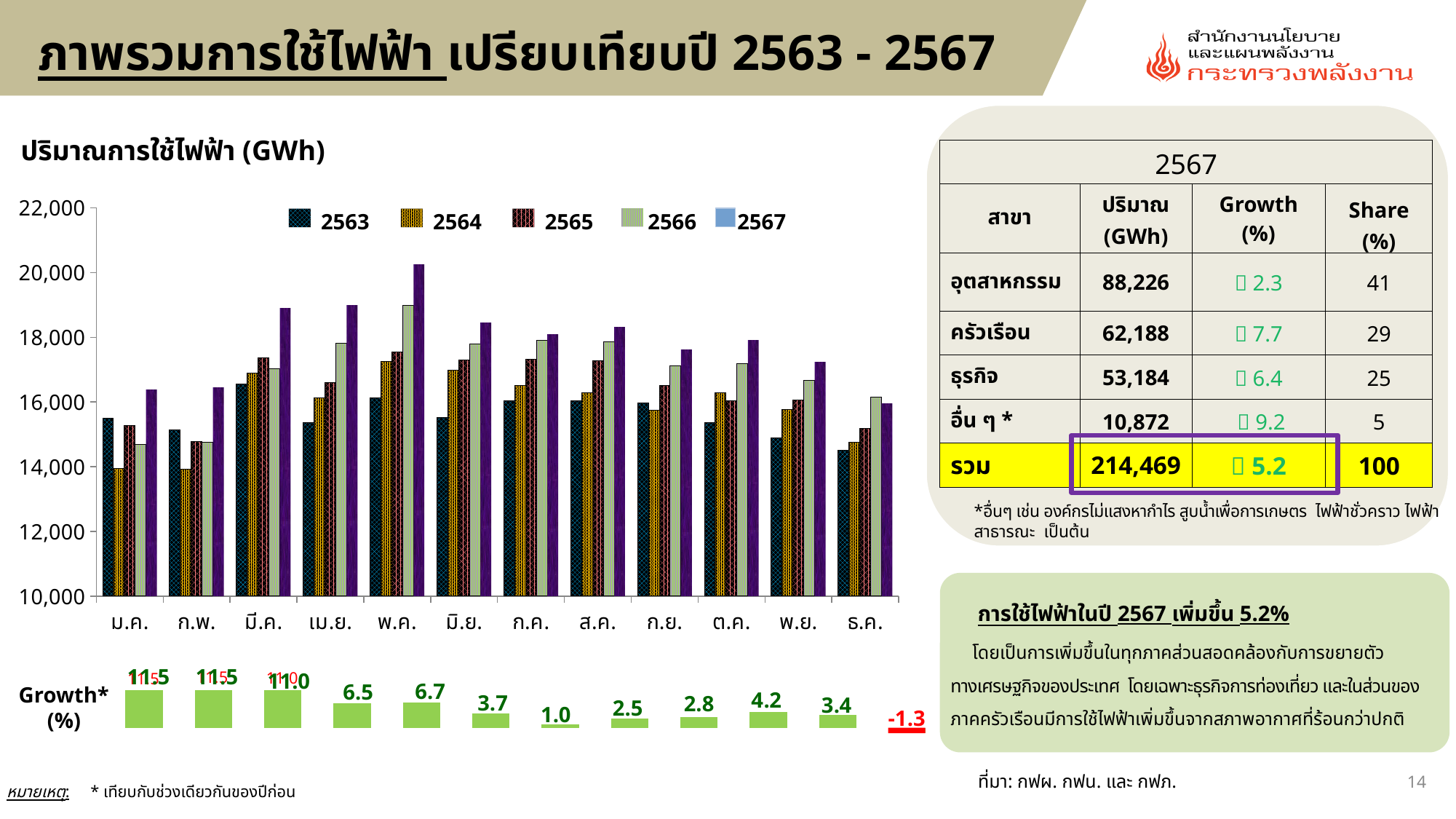
In the ปริมาณการใช้ไฟฟ้า (GWh) chart, which is larger for พ.ค.: the 2563 value or the 2567 value? 2567 In the Growth* (%) chart at the bottom, what is the value for เม.ย.? 6.5 How many series does the legend of the ปริมาณการใช้ไฟฟ้า (GWh) chart list? 5 In the Growth* (%) chart at the bottom, which month has the lowest value? ธ.ค. In the ปริมาณการใช้ไฟฟ้า (GWh) chart, is the 2563 value for ม.ค. greater or less than 14,000? greater What kind of chart is the ปริมาณการใช้ไฟฟ้า (GWh) chart? bar chart In the Growth* (%) chart at the bottom, what is the difference between the values for พ.ค. and เม.ย.? 0.2 In the Growth* (%) chart at the bottom, what is the value for ธ.ค.? -1.3 In the ปริมาณการใช้ไฟฟ้า (GWh) chart, is the 2567 value for พ.ค. greater or less than 20,000? greater How many months are shown on the x axis of the ปริมาณการใช้ไฟฟ้า (GWh) chart? 12 In the ปริมาณการใช้ไฟฟ้า (GWh) chart, which is larger for ม.ค.: the 2563 value or the 2564 value? 2563 In the ปริมาณการใช้ไฟฟ้า (GWh) chart, which month has the highest value for 2567? พ.ค.